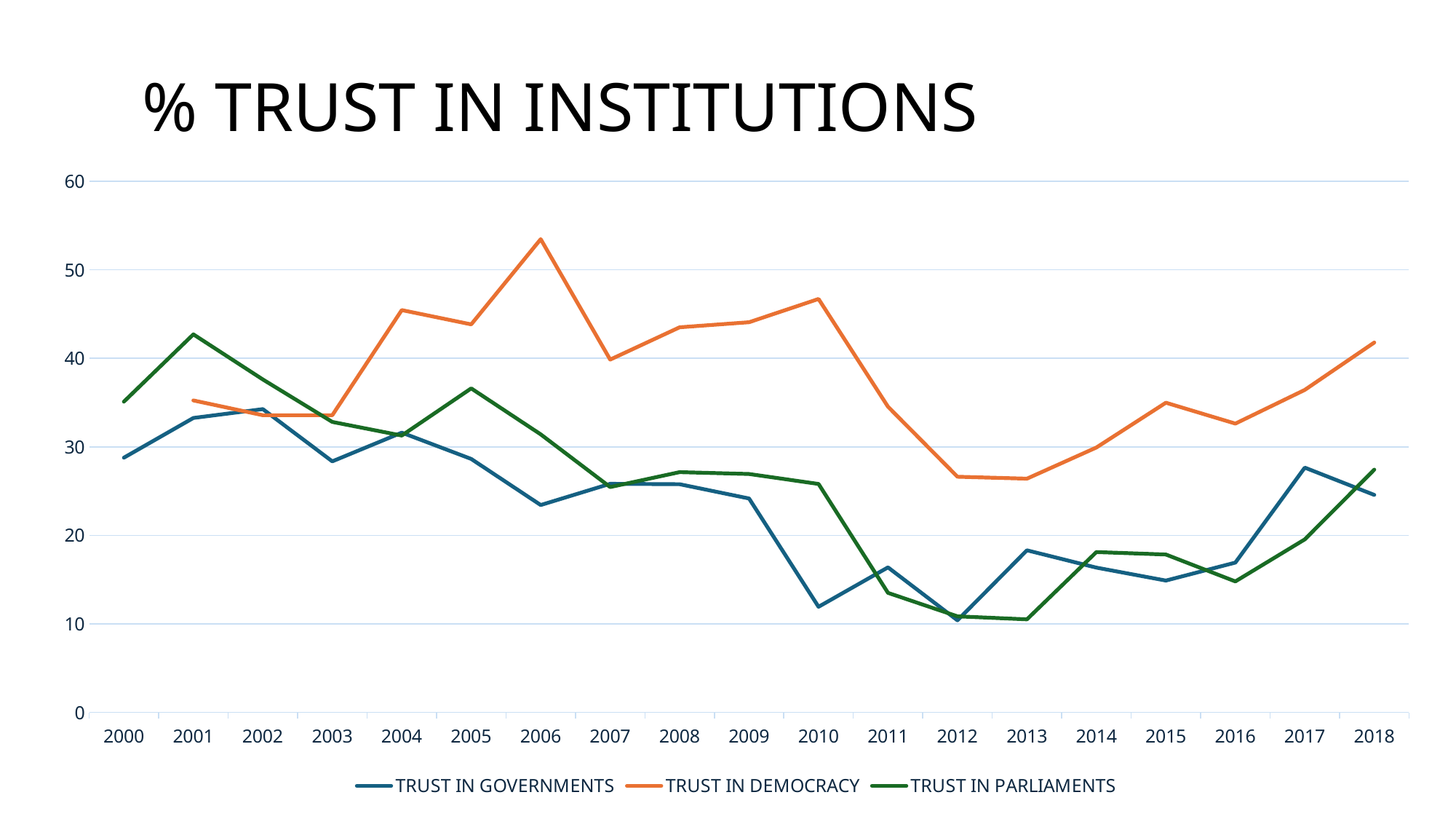
Is the value for Trust in Governments in 2010 greater or less than 20? less Does the Trust in Democracy line rise or fall from 2013 to 2018? Rise How many series does the legend list? 3 What kind of chart is shown on the slide? Line chart What is the title of the chart? % TRUST IN INSTITUTIONS In 2018, which is higher: Trust in Democracy or Trust in Governments? Trust in Democracy In which year does the Trust in Governments line reach its lowest value? 2012 Is the value for Trust in Parliaments in 2018 greater or less than 30? less Is the value for Trust in Democracy in 2006 greater or less than 50? greater In which year does the Trust in Democracy line reach its highest value? 2006 In which year does the Trust in Parliaments line reach its highest value? 2001 How many years are shown along the x axis? 19